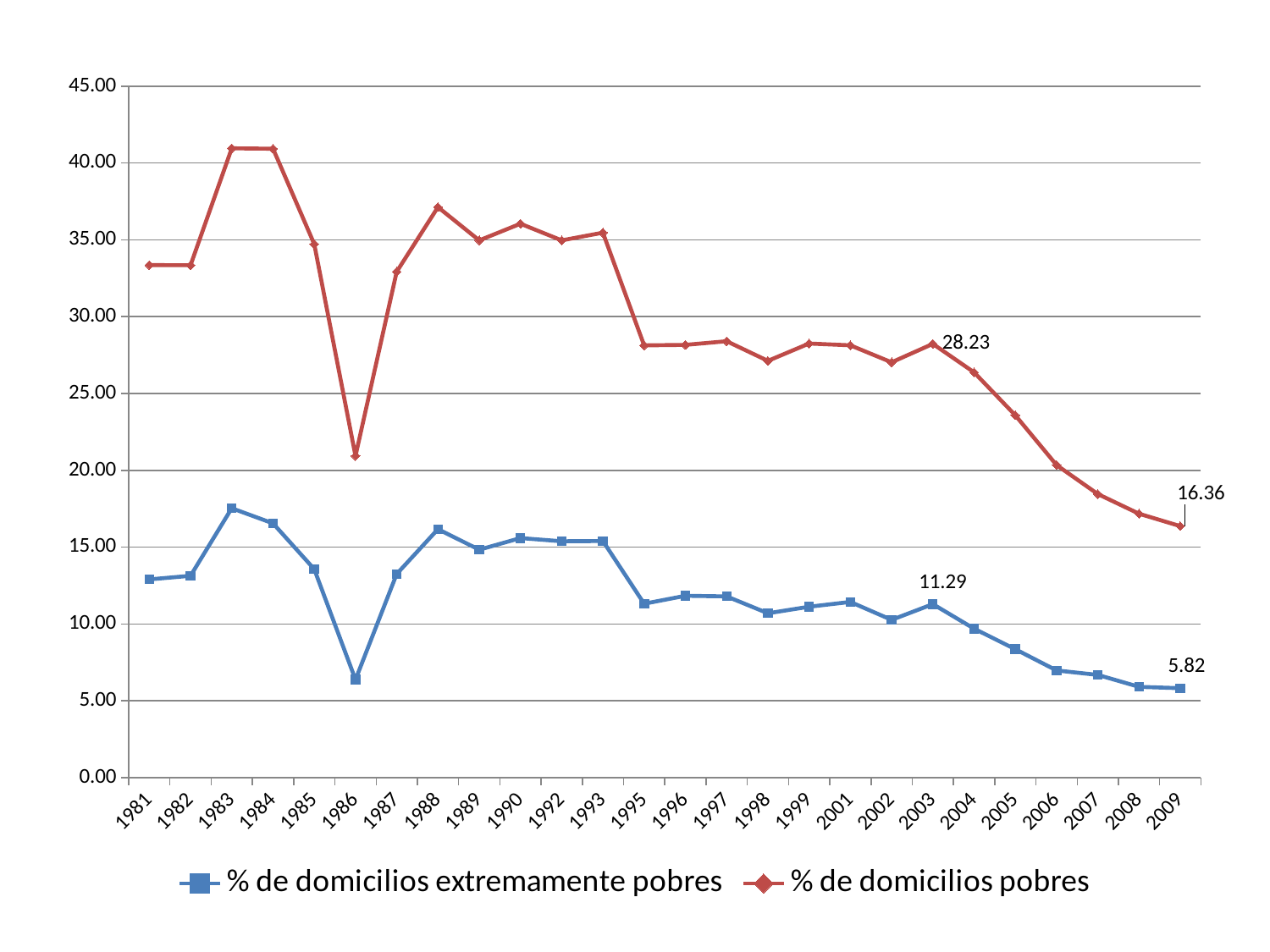
What is the value of '% de domicilios extremamente pobres' in 2009? 5.82 How many series does the legend list? 2 What is the value of '% de domicilios pobres' in 2003? 28.23 Is the value for '% de domicilios pobres' in 1986 greater or less than 25.00? less What is the value of '% de domicilios extremamente pobres' in 2003? 11.29 What is the value of '% de domicilios pobres' in 2009? 16.36 By how much did '% de domicilios pobres' fall from 2003 to 2009? 11.87 In which year is '% de domicilios pobres' at its lowest? 2009 Which series has the higher value in 1983, '% de domicilios pobres' or '% de domicilios extremamente pobres'? % de domicilios pobres What kind of chart is shown on the slide? line chart How many years are shown on the x axis? 26 What is the difference between '% de domicilios pobres' and '% de domicilios extremamente pobres' in 2009? 10.54